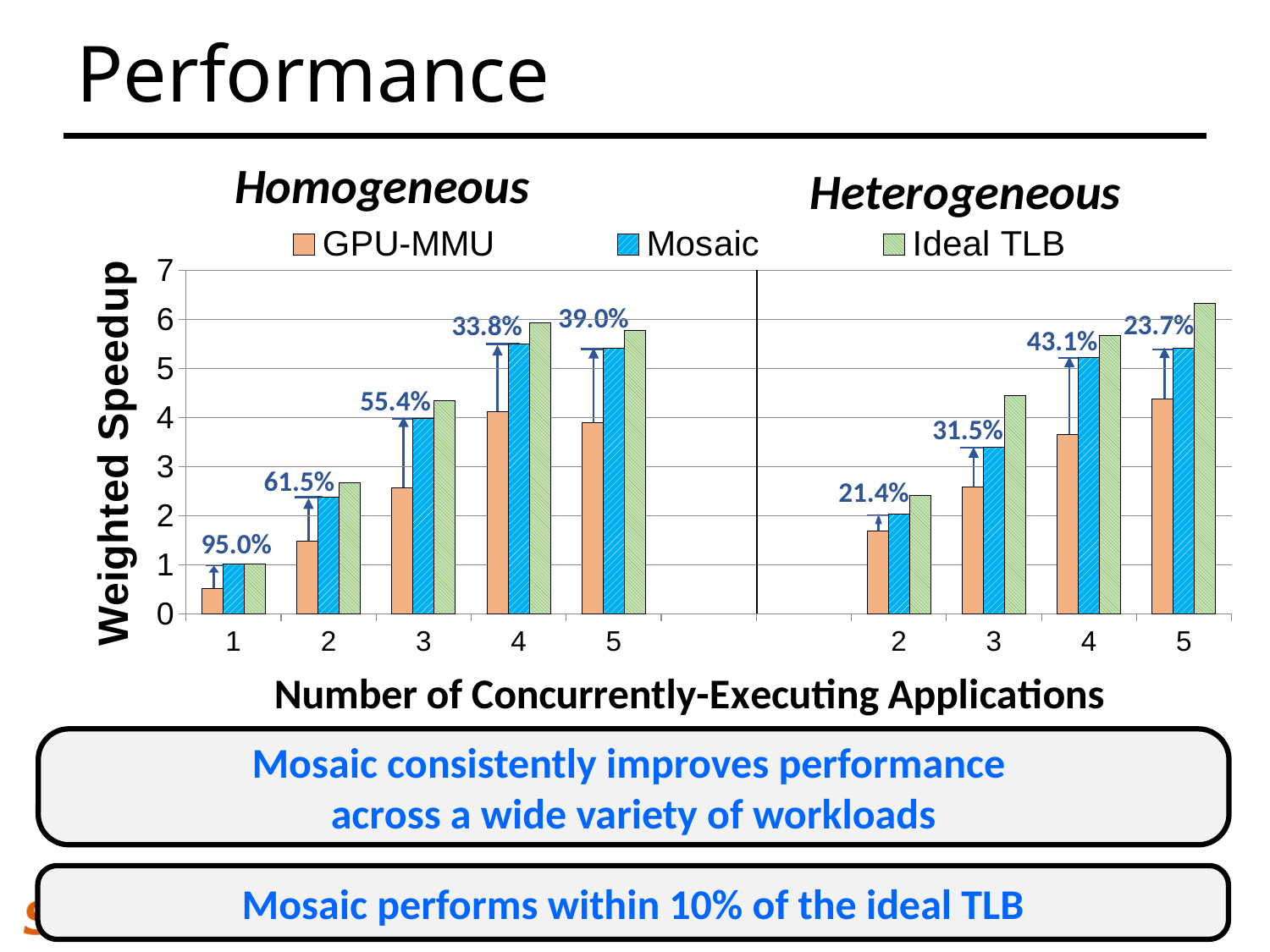
How many series does the legend list? 3 Which group has the highest labelled improvement percentage on the chart? 1 application (Homogeneous), 95.0% Which group has the lowest labelled improvement percentage on the chart? 2 applications (Heterogeneous), 21.4% In the Heterogeneous section, does the Ideal TLB weighted speedup rise or fall as the number of applications increases from 2 to 5? rise What kind of chart is shown on the slide? bar chart What improvement percentage is labelled for 3 concurrently-executing applications in the Homogeneous section? 55.4% How many application-count groups are plotted in the Heterogeneous section? 4 What are the three series named in the legend? GPU-MMU, Mosaic, Ideal TLB How many application-count groups are plotted in the Homogeneous section? 5 What improvement percentage is labelled for 4 concurrently-executing applications in the Heterogeneous section? 43.1% Is the Ideal TLB weighted speedup for 5 applications in the Heterogeneous section greater or less than 6? greater Is the GPU-MMU weighted speedup for 1 application in the Homogeneous section greater or less than 1? less